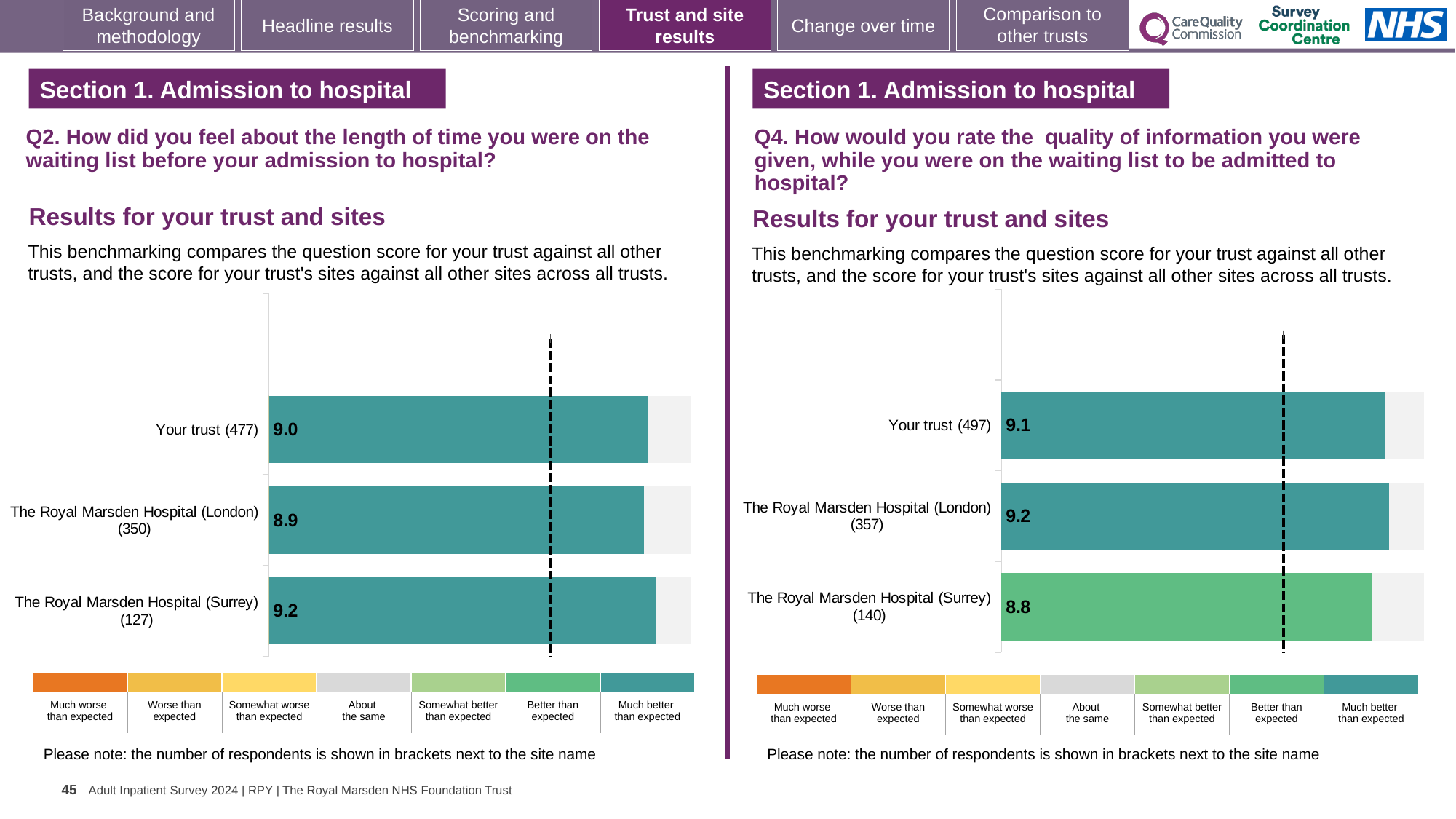
How many categories are plotted in the Q2 chart on the left? 3 In the Q4 chart on the right, what is the score for The Royal Marsden Hospital (Surrey) (140)? 8.8 What kind of chart is the Q4 chart on the right? Bar chart In the Q2 chart on the left, what is the difference between the scores for The Royal Marsden Hospital (Surrey) and The Royal Marsden Hospital (London)? 0.3 In the Q4 chart on the right, what is the difference between the scores for The Royal Marsden Hospital (London) and The Royal Marsden Hospital (Surrey)? 0.4 In the Q2 chart on the left, which category has the lowest score? The Royal Marsden Hospital (London) (350) In the Q4 chart on the right, which category has the highest score? The Royal Marsden Hospital (London) (357) In the Q2 chart on the left, what is the score for Your trust (477)? 9.0 In the Q4 chart on the right, what is the score for Your trust (497)? 9.1 In the Q2 chart on the left, which category has the highest score? The Royal Marsden Hospital (Surrey) (127) In the Q2 chart on the left, what is the score for The Royal Marsden Hospital (London) (350)? 8.9 In the Q4 chart on the right, which is larger, the score for Your trust or the score for The Royal Marsden Hospital (Surrey)? Your trust